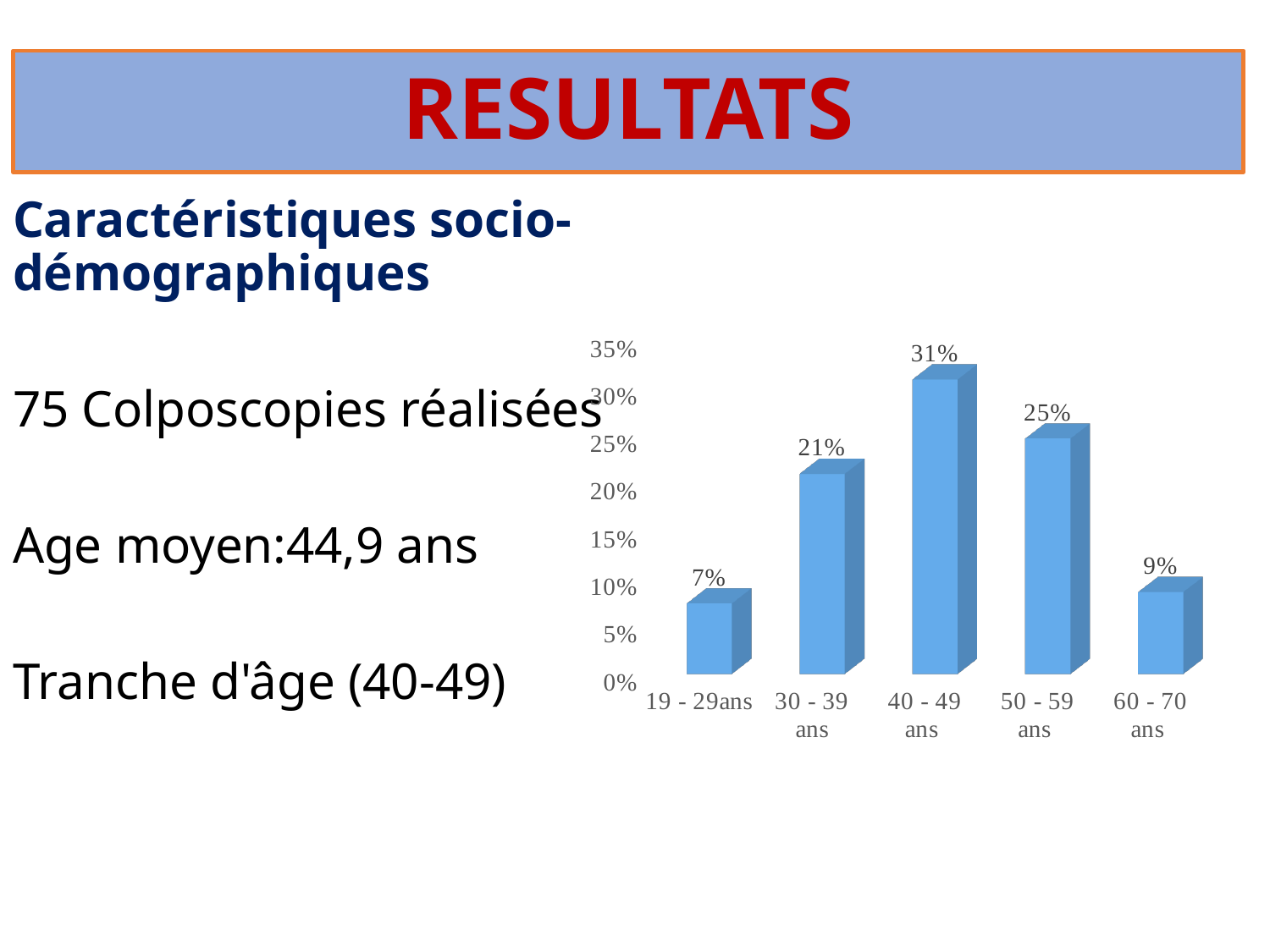
Which is larger, the value for 30 - 39 ans or the value for 50 - 59 ans? 50 - 59 ans What is the value for the 19 - 29ans age group? 7% What kind of chart is shown on the slide? bar chart What is the value for the 60 - 70 ans age group? 9% What is the highest value shown on the vertical axis of the chart? 35% What is the difference between the values for 30 - 39 ans and 19 - 29ans? 14% What is the value for the 40 - 49 ans age group? 31% Is the value for 50 - 59 ans greater or less than 20%? greater Which age group has the lowest value? 19 - 29ans What is the difference between the values for 40 - 49 ans and 50 - 59 ans? 6% How many age groups are shown in the chart? 5 Which age group has the highest value? 40 - 49 ans